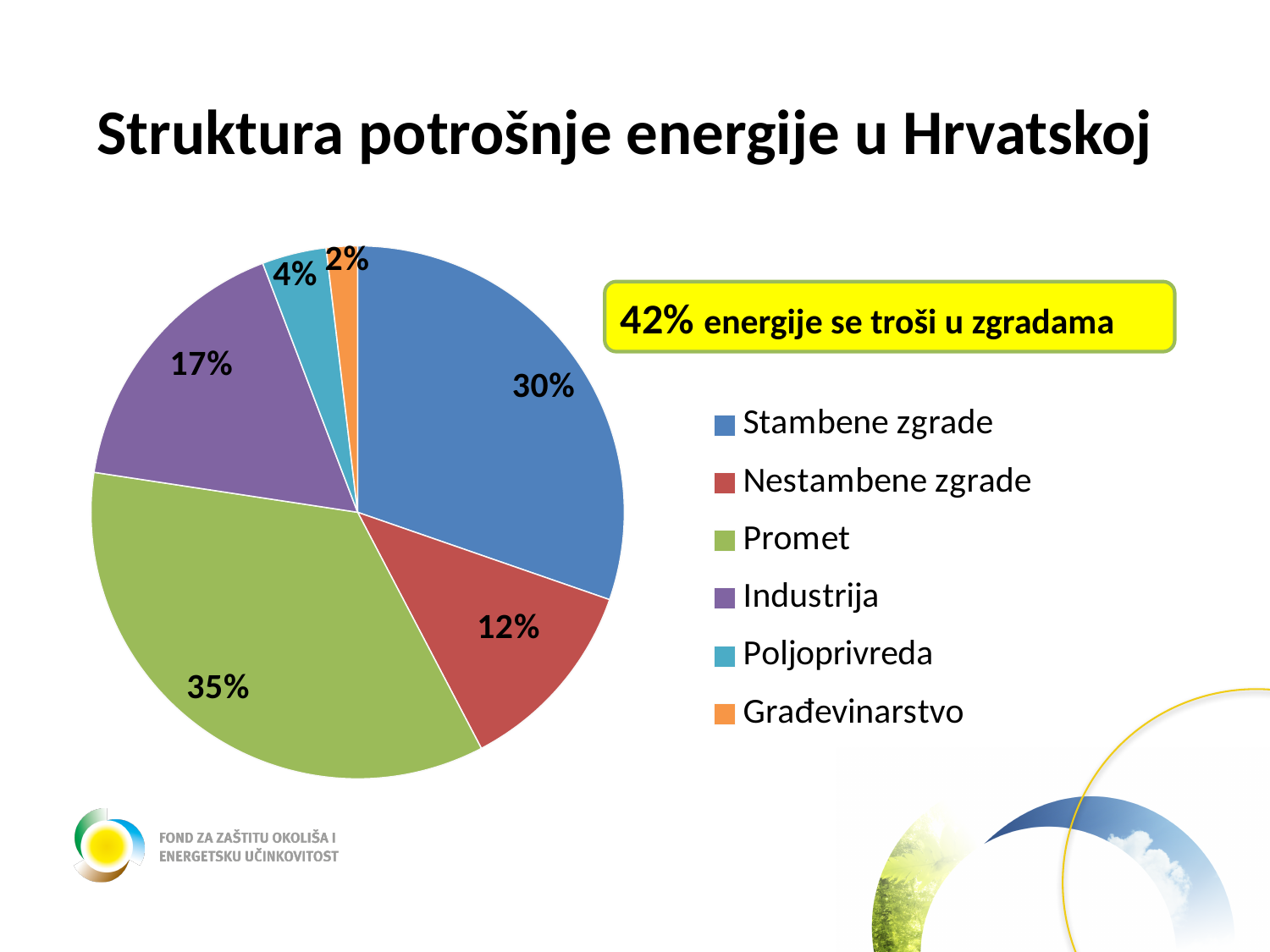
What is the title of the slide containing the chart? Struktura potrošnje energije u Hrvatskoj Which category has the smallest slice of the pie? Građevinarstvo What share of the pie does Promet account for? 35% What is the difference between the shares of Promet and Nestambene zgrade? 23% Which is larger, the share for Industrija or the share for Nestambene zgrade? Industrija What is the value shown for Poljoprivreda? 4% What kind of chart is shown on the slide? Pie chart How many categories does the pie chart show? 6 What is the value shown for Industrija? 17% What is the combined share of Stambene zgrade and Nestambene zgrade? 42% Which category has the largest slice of the pie? Promet What share of the pie does Stambene zgrade account for? 30%